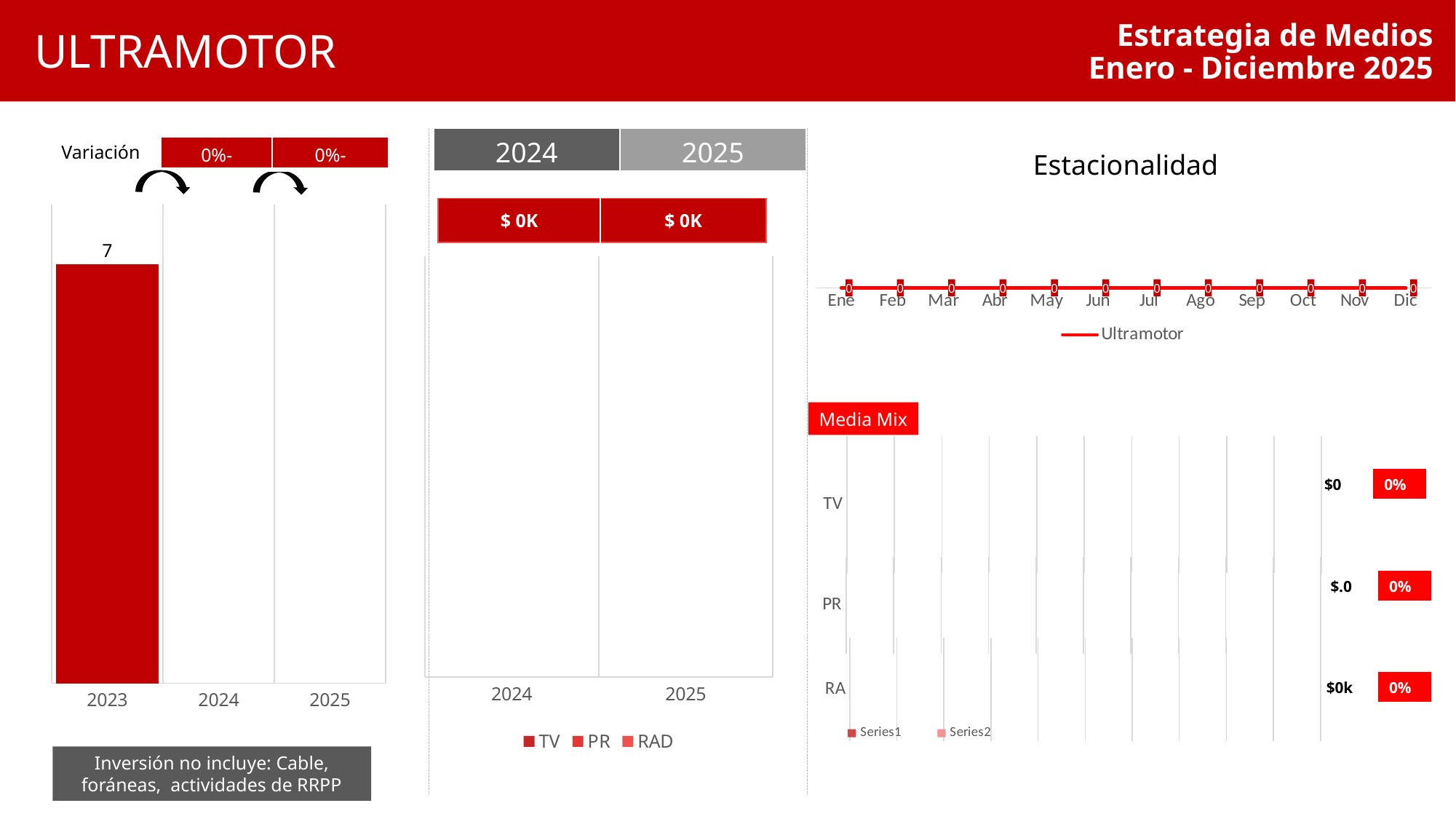
On the Estacionalidad chart, how many months are shown on the x axis? 12 On the left bar chart, which year has the highest bar? 2023 On the middle chart with years 2024 and 2025, what are the legend entries? TV, PR, RAD On the left bar chart, how many year categories are shown on the x axis? 3 What is the title of the line chart in the upper right? Estacionalidad What kind of chart is the left chart with years 2023, 2024 and 2025? bar chart On the middle chart with years 2024 and 2025, how many series does the legend list? 3 On the Media Mix chart, what percentage is shown for TV? 0% On the Estacionalidad chart, what is the value for Jul? 0 On the left bar chart, what is the value for 2023? 7 On the Estacionalidad chart, how many series does the legend list? 1 On the middle chart, what value is shown in the red box above 2024? $ 0K